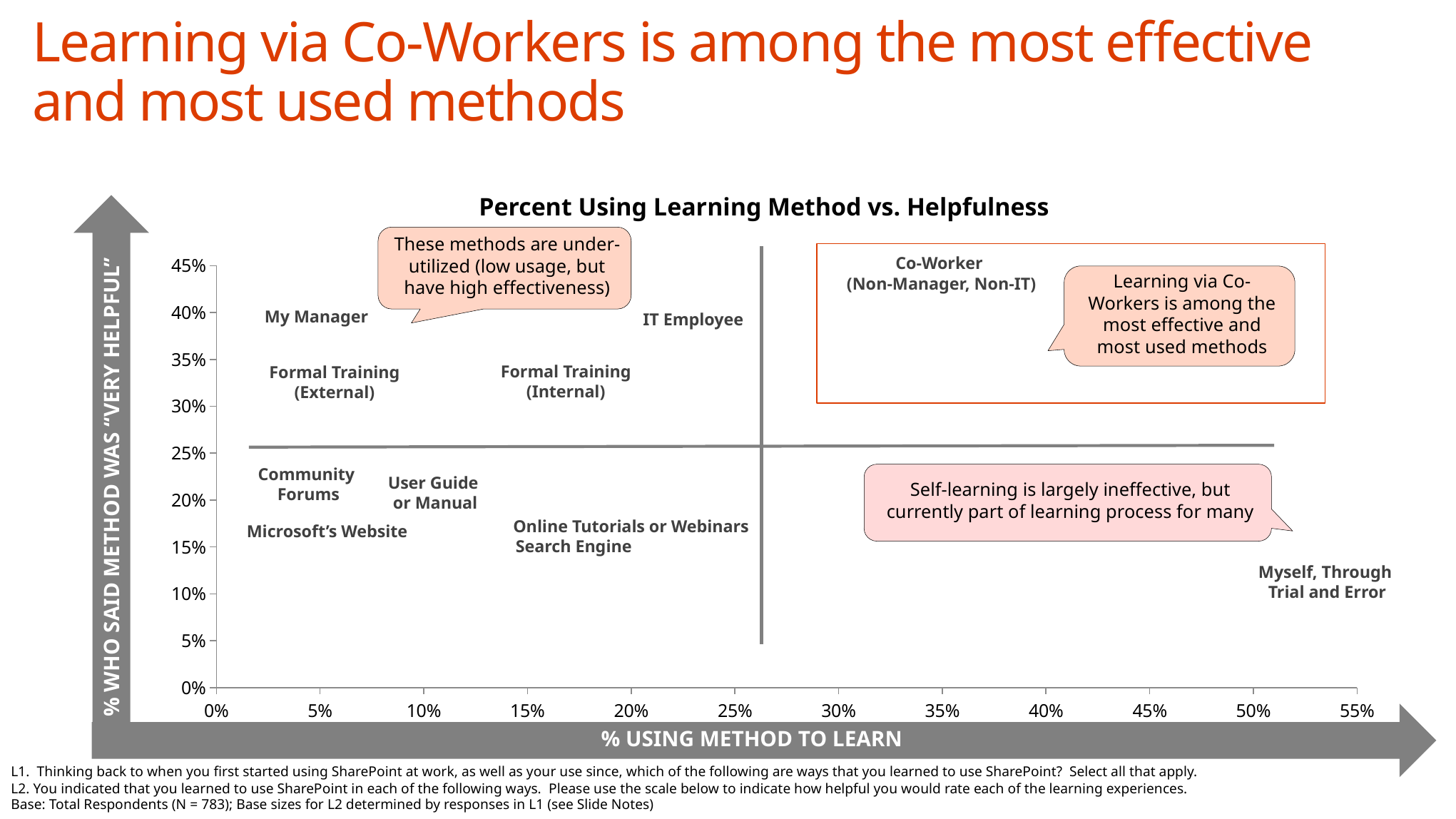
Is the percentage using "Myself, Through Trial and Error" greater or less than 45%? greater Is the percentage using "Microsoft's Website" greater or less than 15%? less Which has a higher percentage saying the method was very helpful, IT Employee or Search Engine? IT Employee What kind of chart is shown on the slide? Scatter chart Which learning method has the highest percentage of people using it? Myself, Through Trial and Error Is the percentage using "Co-Worker (Non-Manager, Non-IT)" greater or less than 30%? greater What is the title of the chart? Percent Using Learning Method vs. Helpfulness How many learning methods are plotted on the chart? 11 What is the label of the horizontal axis of the chart? % USING METHOD TO LEARN